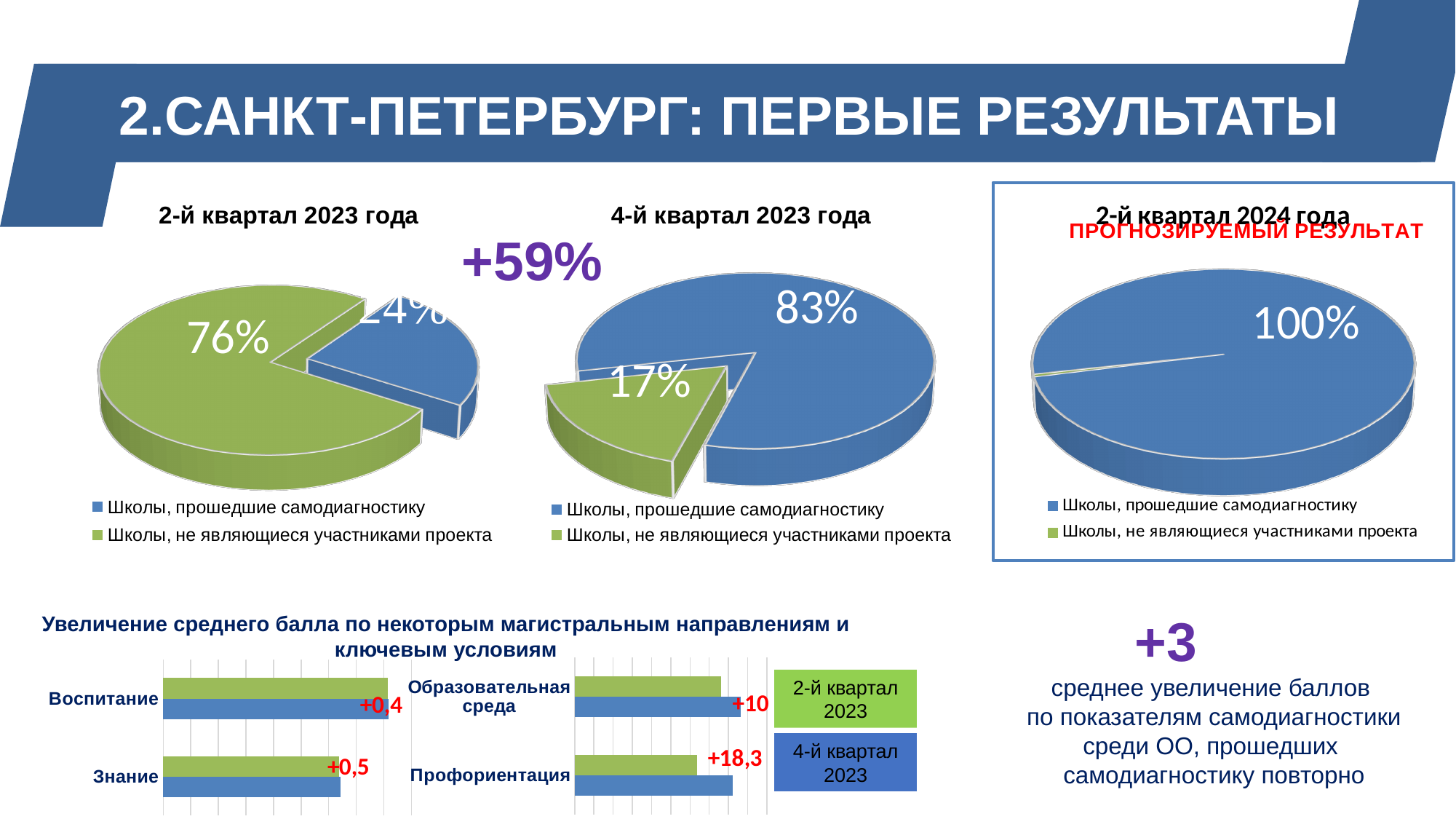
In the bar chart "Увеличение среднего балла по некоторым магистральным направлениям и ключевым условиям", what increase is labelled for "Воспитание"? +0,4 In the pie chart titled "4-й квартал 2023 года", what share is shown for "Школы, прошедшие самодиагностику"? 83% In the pie chart titled "4-й квартал 2023 года", which category has the larger slice? Школы, прошедшие самодиагностику In the pie chart titled "4-й квартал 2023 года", what share is shown for "Школы, не являющиеся участниками проекта"? 17% In the pie chart titled "2-й квартал 2023 года", what share is shown for "Школы, не являющиеся участниками проекта"? 76% In the bar chart "Увеличение среднего балла по некоторым магистральным направлениям и ключевым условиям", which colour represents "4-й квартал 2023"? Blue In the pie chart titled "2-й квартал 2023 года", which category has the smaller slice? Школы, прошедшие самодиагностику What kind of chart is used for "2-й квартал 2023 года"? Pie chart In the bar chart "Увеличение среднего балла по некоторым магистральным направлениям и ключевым условиям", what increase is labelled for "Профориентация"? +18,3 How many series does the legend of the "4-й квартал 2023 года" chart list? 2 In the bar chart "Увеличение среднего балла по некоторым магистральным направлениям и ключевым условиям", which category shows the largest labelled increase? Профориентация